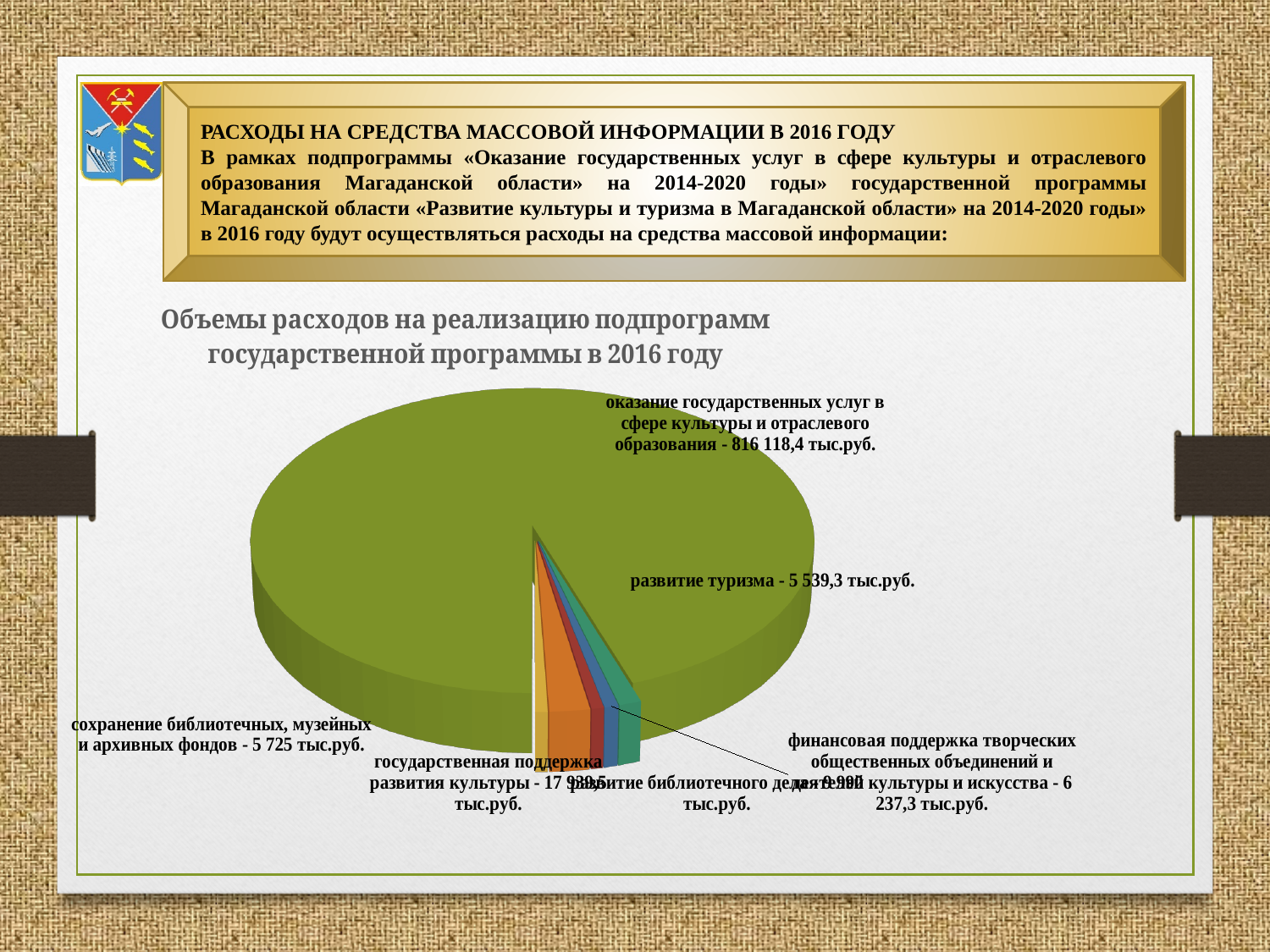
What is the difference between the value for 'сохранение библиотечных, музейных и архивных фондов' and the value for 'развитие туризма'? 185,7 тыс.руб. What is the value for 'финансовая поддержка творческих общественных объединений и деятелей культуры и искусства'? 6 237,3 тыс.руб. What is the difference between the value for 'финансовая поддержка творческих общественных объединений и деятелей культуры и искусства' and the value for 'сохранение библиотечных, музейных и архивных фондов'? 512,3 тыс.руб. What is the title of the pie chart? Объемы расходов на реализацию подпрограмм государственной программы в 2016 году What colour is the largest slice of the pie chart? green Which is larger: the value for 'развитие туризма' or for 'сохранение библиотечных, музейных и архивных фондов'? сохранение библиотечных, музейных и архивных фондов How many slices does the pie chart have? 6 What is the value for 'развитие туризма'? 5 539,3 тыс.руб. What kind of chart is shown on the slide? pie chart What is the value for 'сохранение библиотечных, музейных и архивных фондов'? 5 725 тыс.руб. What is the value for 'оказание государственных услуг в сфере культуры и отраслевого образования'? 816 118,4 тыс.руб. Which category has the largest slice in the pie chart? оказание государственных услуг в сфере культуры и отраслевого образования